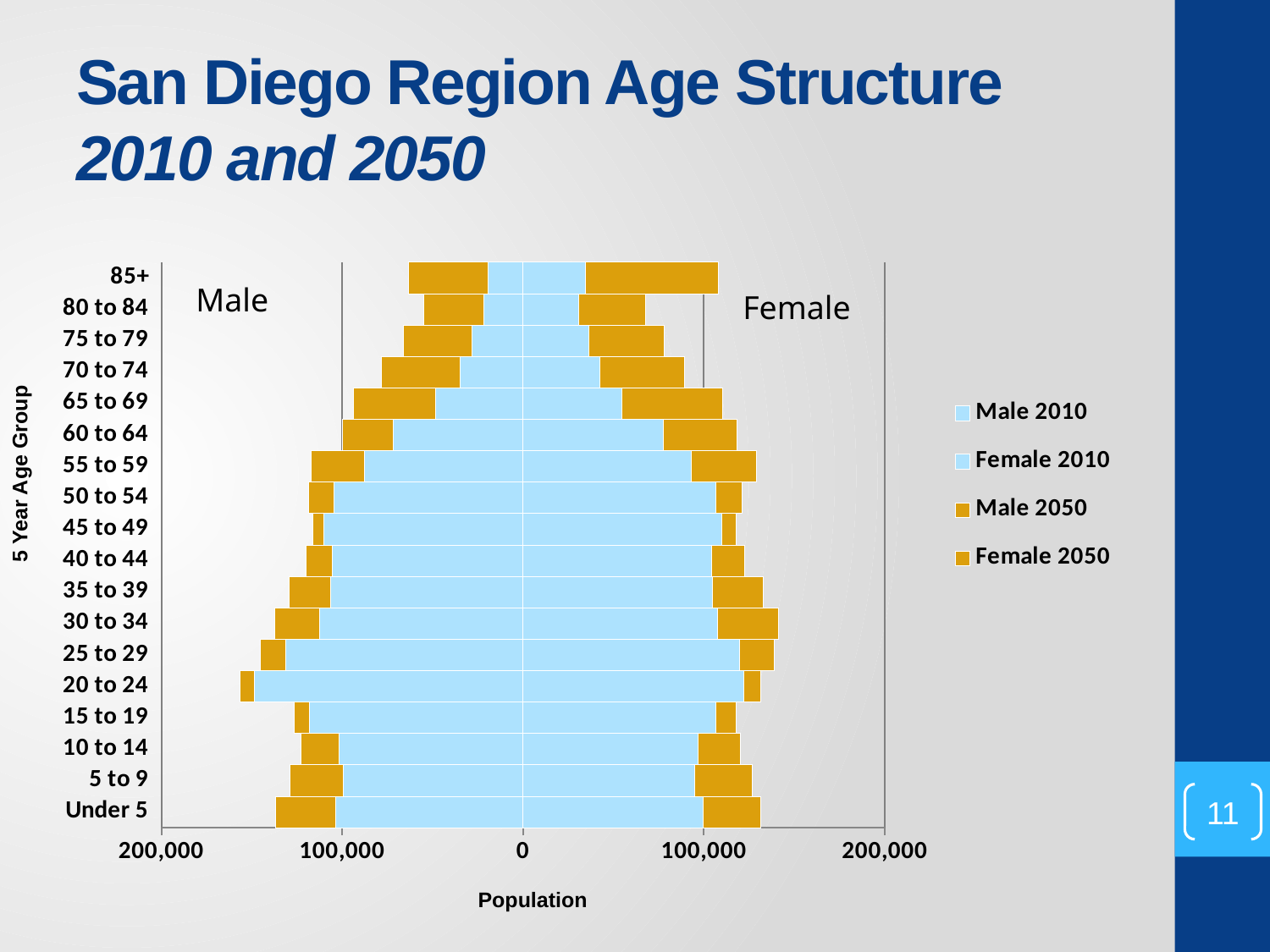
Is the Male 2010 value for 20 to 24 greater or less than 100,000? greater How many age groups are shown on the vertical axis? 18 Is the Female 2010 value for 25 to 29 greater or less than 100,000? greater Do the Male 2010 values generally rise or fall as the age groups go from 25 to 29 up to 85+? fall Which is larger, the Male 2050 value for 85+ or the Male 2050 value for 45 to 49? 45 to 49 What is the title of the horizontal axis? Population How many series does the legend list? 4 Which age group has the largest Male 2010 value? 20 to 24 Which age group has the smallest Male 2010 value? 85+ Is the Male 2010 value for 65 to 69 greater or less than 100,000? less What kind of chart is shown on the slide? bar chart